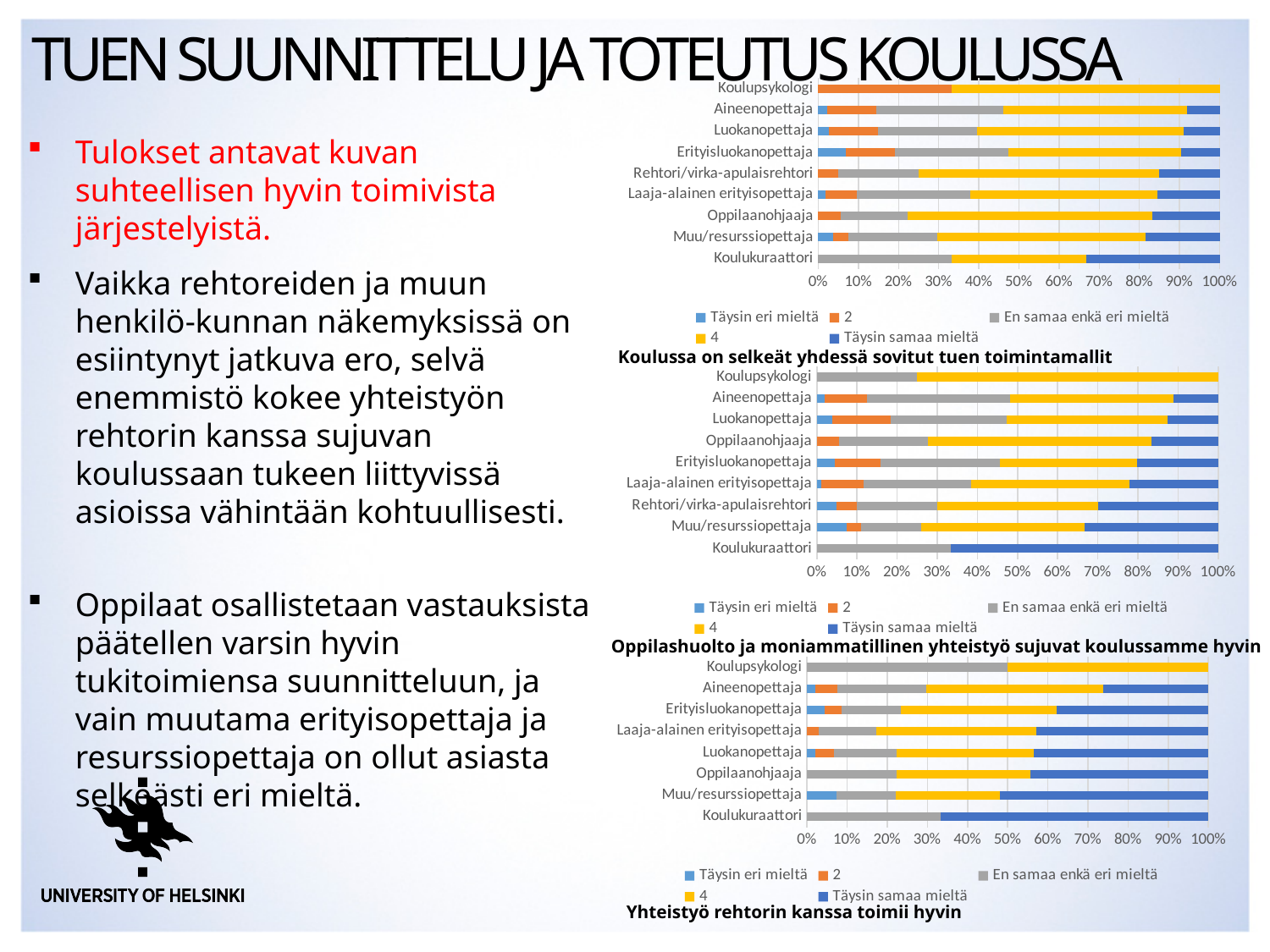
In the middle chart, is the 'Täysin samaa mieltä' share for Koulukuraattori greater or less than 50%? greater What kind of chart is the top chart on the slide? Stacked bar chart In the bottom chart, is the 'Täysin samaa mieltä' share for Koulukuraattori greater or less than 50%? greater How many respondent groups (categories) are shown in the bottom chart? 8 What is the first legend entry of the middle chart? Täysin eri mieltä In the bottom chart, which has the larger 'Täysin samaa mieltä' share: Koulupsykologi or Koulukuraattori? Koulukuraattori In the top chart, which has the larger 'Täysin samaa mieltä' share: Koulupsykologi or Koulukuraattori? Koulukuraattori How many series does the legend of the top chart list? 5 In the top chart, is the 'Täysin samaa mieltä' share for Koulukuraattori greater or less than 20%? greater What is the highest value shown on the x axis of the bottom chart? 100% In the bottom chart, which category has the largest 'Täysin samaa mieltä' share? Koulukuraattori How many respondent groups (categories) are shown in the top chart? 9